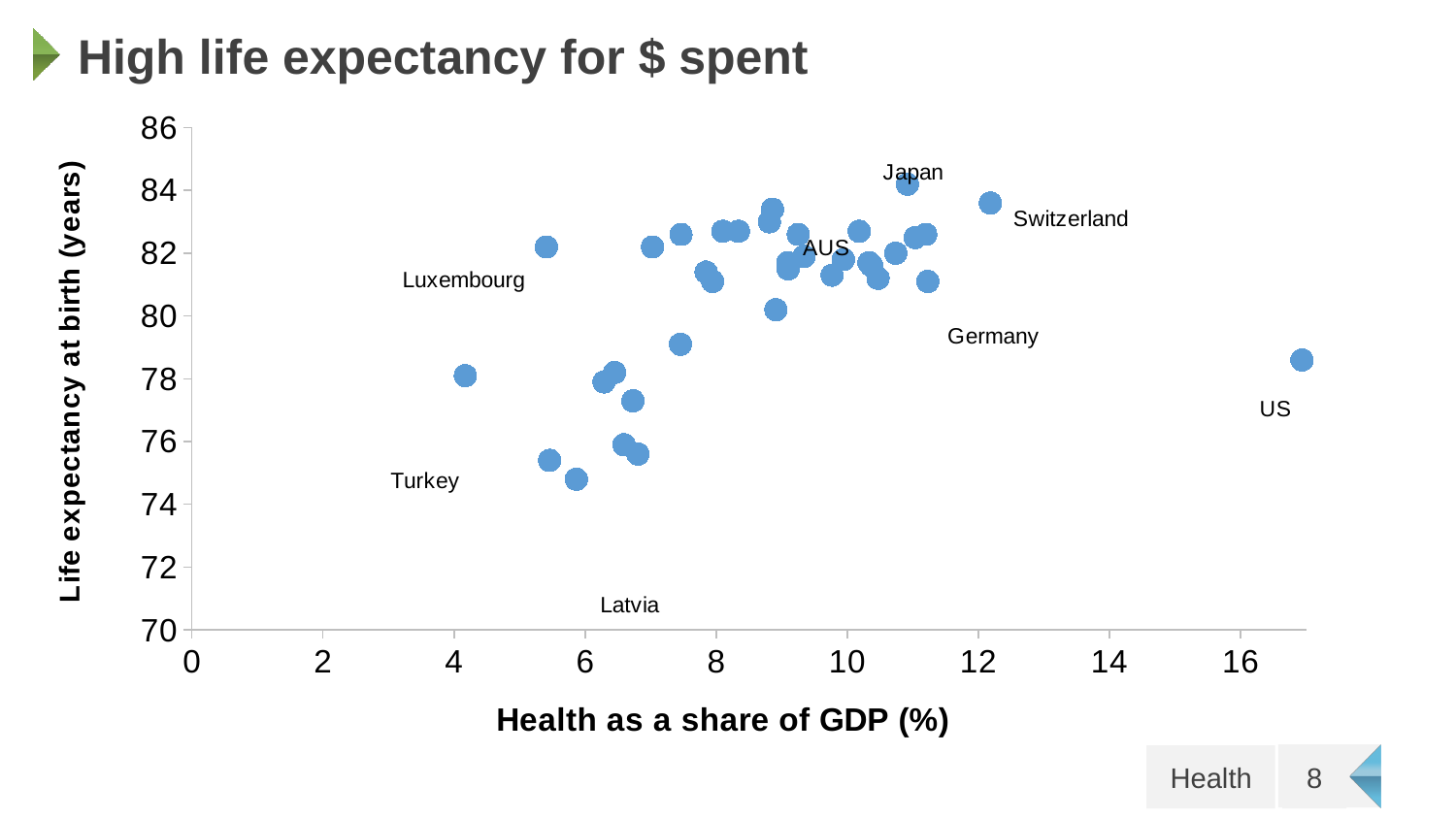
Which has the larger health share of GDP, the US or Japan? US Is the life expectancy for Luxembourg greater or less than 80? greater What kind of chart is shown on the slide? scatter chart What is the title of the chart? High life expectancy for $ spent Is the life expectancy for Switzerland greater or less than 82? greater How many countries are labelled by name on the chart? 8 Is the health share of GDP for Germany greater or less than 10? greater What is the label of the x axis? Health as a share of GDP (%) Which labelled country has the highest health share of GDP? US